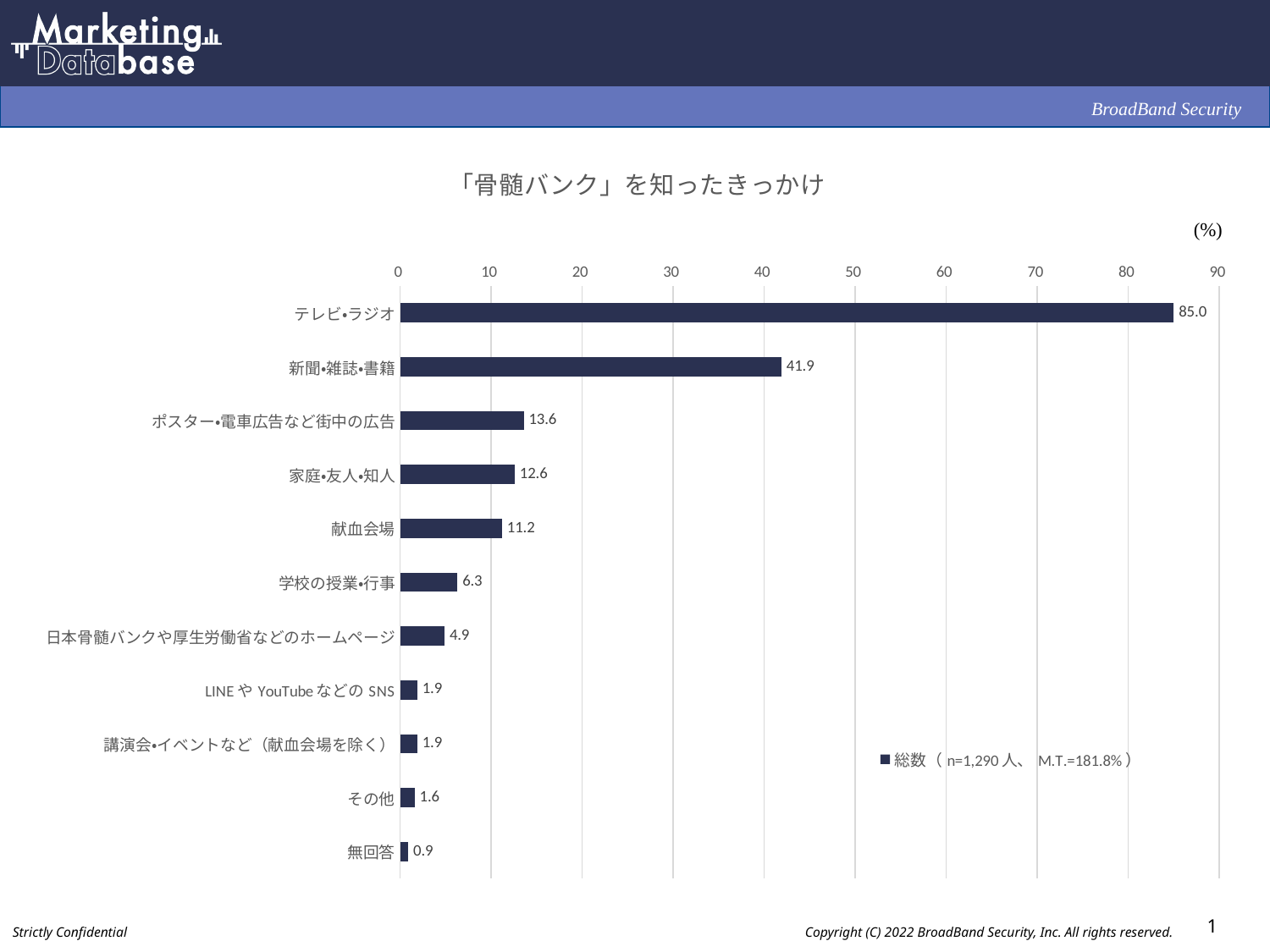
What is the value for 日本骨髄バンクや厚生労働省などのホームページ? 4.9 What is the difference between the values for テレビ•ラジオ and 新聞•雑誌•書籍? 43.1 What kind of chart is shown on the slide? Bar chart How many categories are shown in the chart? 11 Which category has the highest value? テレビ•ラジオ Which is larger, the value for ポスター•電車広告など街中の広告 or the value for 家庭•友人•知人? ポスター•電車広告など街中の広告 What is the value for テレビ•ラジオ? 85.0 What is the value for 新聞•雑誌•書籍? 41.9 What is the value for 献血会場? 11.2 What is the title of the chart? 「骨髄バンク」を知ったきっかけ How many series does the legend list? 1 Which category has the lowest value? 無回答